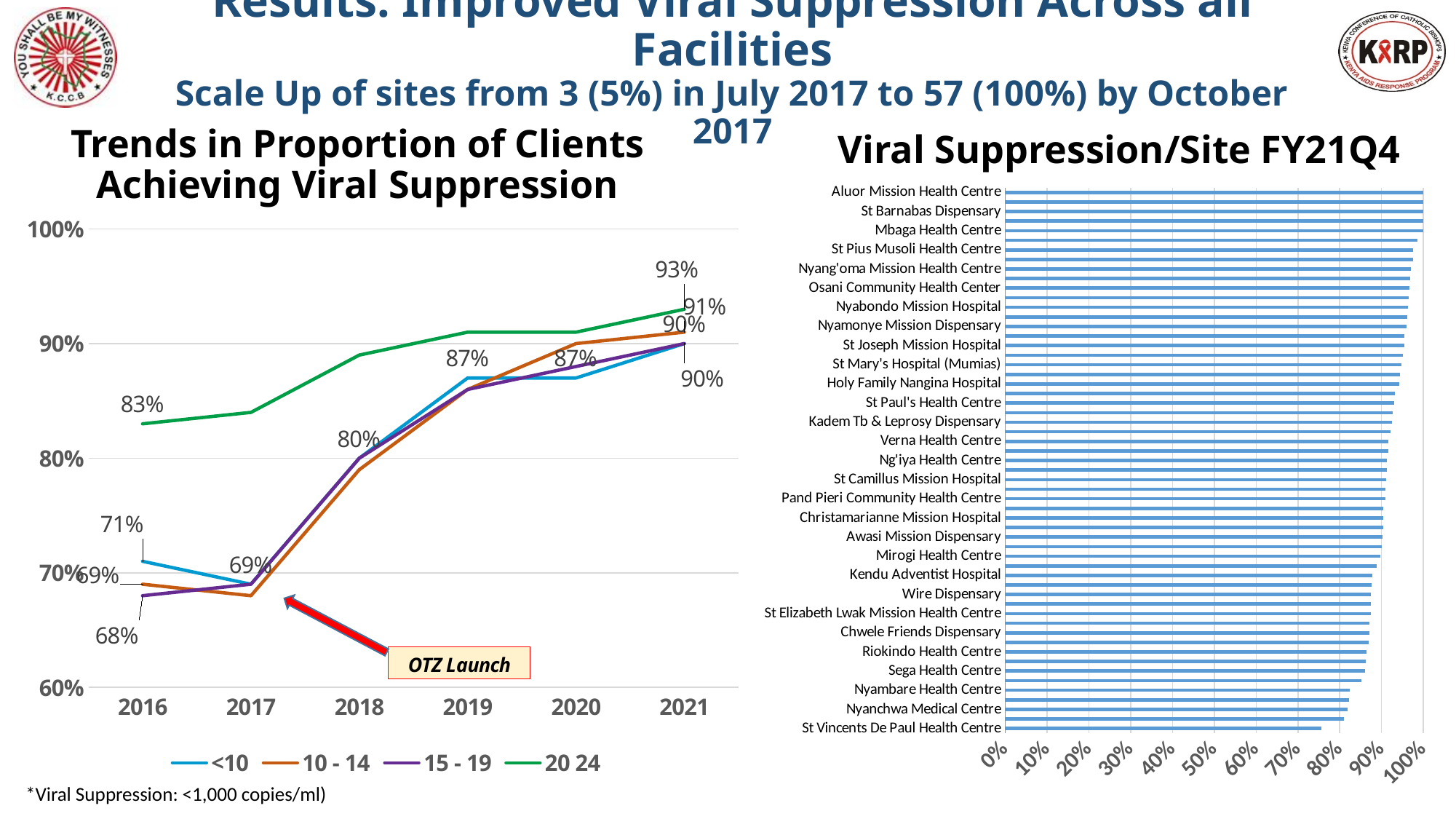
In the 'Viral Suppression/Site FY21Q4' chart, which labelled site has the lowest viral suppression? St Vincents De Paul Health Centre In the 'Trends in Proportion of Clients Achieving Viral Suppression' chart, which age group has the highest value in 2021? 20 24 In the 'Trends in Proportion of Clients Achieving Viral Suppression' chart, by how many percentage points did the 20 24 age group increase from 2016 to 2021? 10 percentage points What kind of chart is the 'Trends in Proportion of Clients Achieving Viral Suppression' chart? line chart In the 'Trends in Proportion of Clients Achieving Viral Suppression' chart, what is the value for the 20 24 age group in 2021? 93% In the 'Trends in Proportion of Clients Achieving Viral Suppression' chart, what is the value for the 20 24 age group in 2016? 83% In the 'Viral Suppression/Site FY21Q4' chart, is the value for St Vincents De Paul Health Centre greater or less than 80%? less In the 'Trends in Proportion of Clients Achieving Viral Suppression' chart, how many series does the legend list? 4 In the 'Trends in Proportion of Clients Achieving Viral Suppression' chart, which age group has the lowest value in 2016? 15 - 19 What kind of chart is the 'Viral Suppression/Site FY21Q4' chart? bar chart In the 'Trends in Proportion of Clients Achieving Viral Suppression' chart, how many years are shown on the x axis? 6 In the 'Trends in Proportion of Clients Achieving Viral Suppression' chart, what is the value for the <10 age group in 2016? 71%